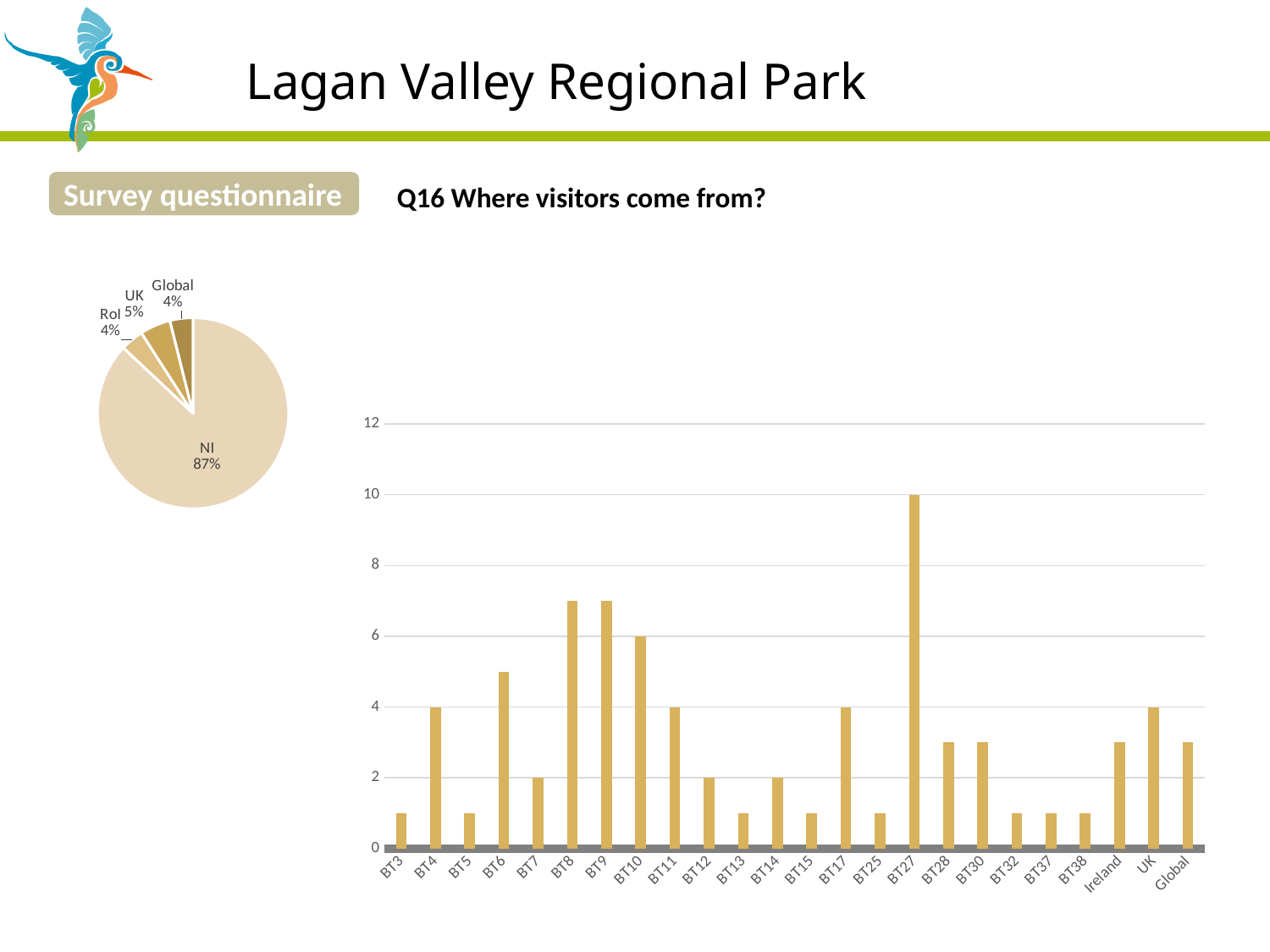
In the pie chart, what is the difference between the NI share and the UK share? 82% In the bar chart on the right, which category has the highest value? BT27 In the bar chart on the right, is the value for BT8 greater or less than 6? greater In the bar chart on the right, what is the value for BT27? 10 What kind of chart is the chart on the right of the slide? bar chart In the pie chart, what share of visitors come from NI? 87% In the pie chart, how many slices are there? 4 In the bar chart on the right, how many categories are shown on the x axis? 24 In the pie chart, what share of visitors come from the UK? 5% In the bar chart on the right, what is the value for BT10? 6 In the pie chart, which origin has the largest share? NI In the pie chart, which is larger, the share for UK or the share for RoI? UK